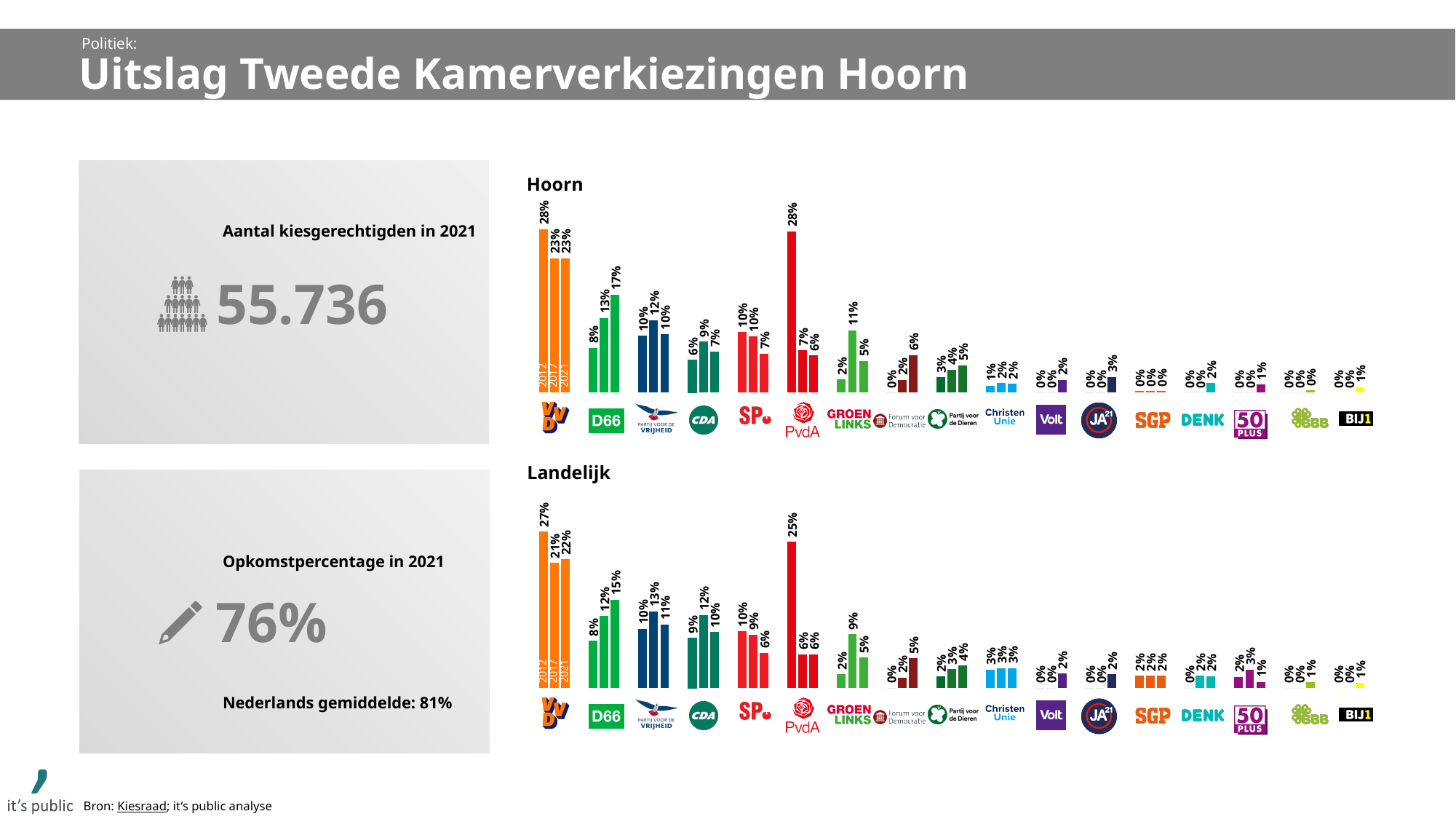
In the Landelijk chart, which is larger: D66 in 2021 or PVV in 2021? D66 in 2021 In the Hoorn chart, what percentage did D66 get in 2021? 17% In the Landelijk chart, what percentage did GroenLinks get in 2017? 9% In the Landelijk chart, what percentage did VVD get in 2021? 22% In the Hoorn chart, do the values for D66 rise or fall from 2012 to 2021? rise What type of chart is the Landelijk chart? bar chart In the Landelijk chart, what is the difference between PvdA's 2012 and 2021 percentages? 19% In the Hoorn chart, what percentage did PvdA get in 2012? 28% In the Hoorn chart, what is the difference between D66's 2021 and 2012 percentages? 9% In the Hoorn chart, which party had the highest percentage in 2021? VVD How many years (series) are shown for each party in the Hoorn chart? 3 In the Hoorn chart, which is larger: PVV in 2021 or CDA in 2021? PVV in 2021